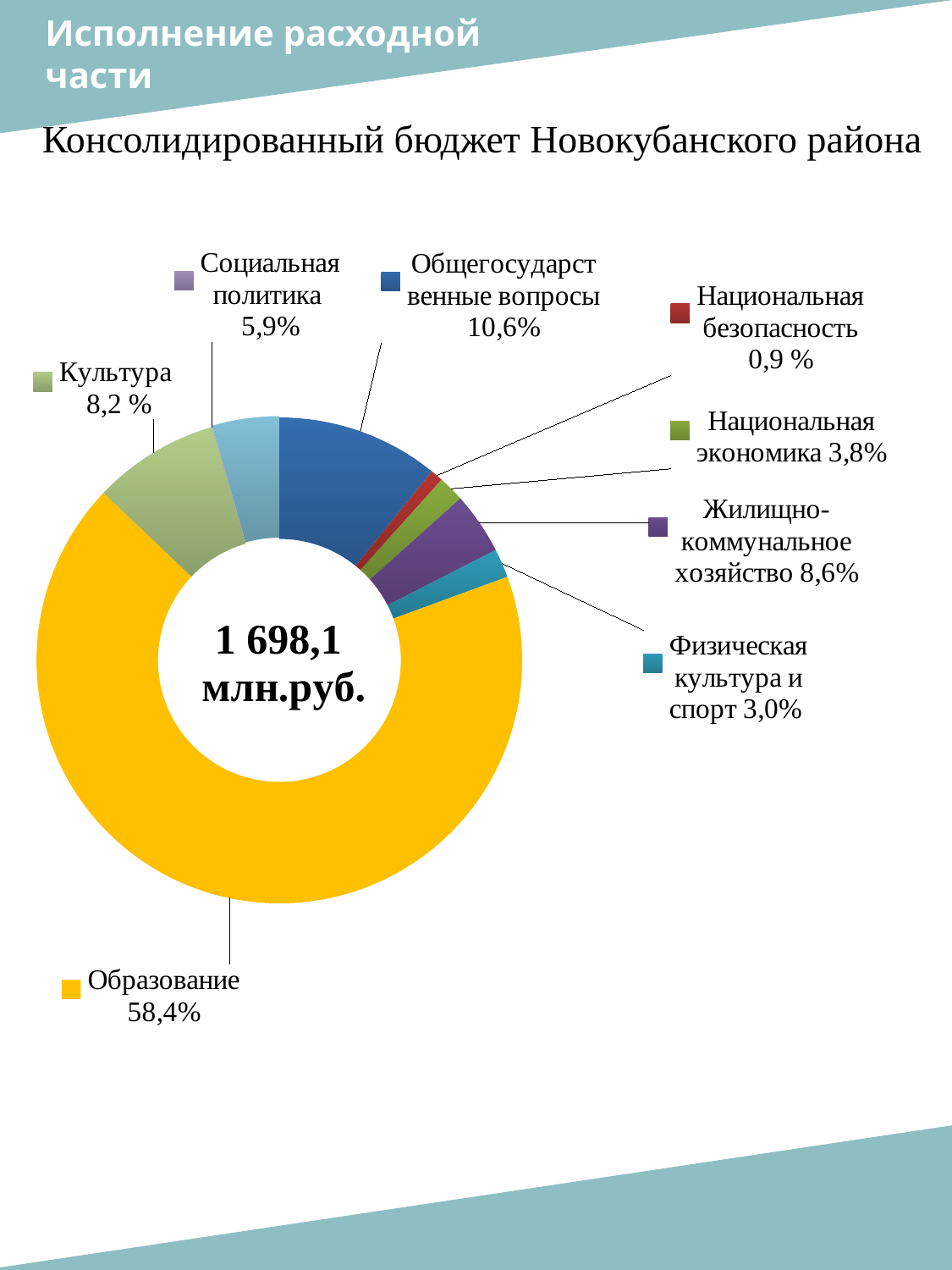
What share of the budget goes to Общегосударственные вопросы? 10,6% Which category has the smallest share of the budget? Национальная безопасность What total amount is shown in the centre of the chart? 1 698,1 млн.руб. Which category has the largest share of the budget? Образование What is the difference in percentage points between Общегосударственные вопросы and Национальная экономика? 6,8 Which has a larger share: Культура or Социальная политика? Культура What share of the budget goes to Образование? 58,4% What share of the budget goes to Национальная безопасность? 0,9 % What share of the budget goes to Физическая культура и спорт? 3,0% What share of the budget goes to Жилищно-коммунальное хозяйство? 8,6% What kind of chart is shown on the slide? Doughnut (pie) chart How many categories are shown in the chart? 8